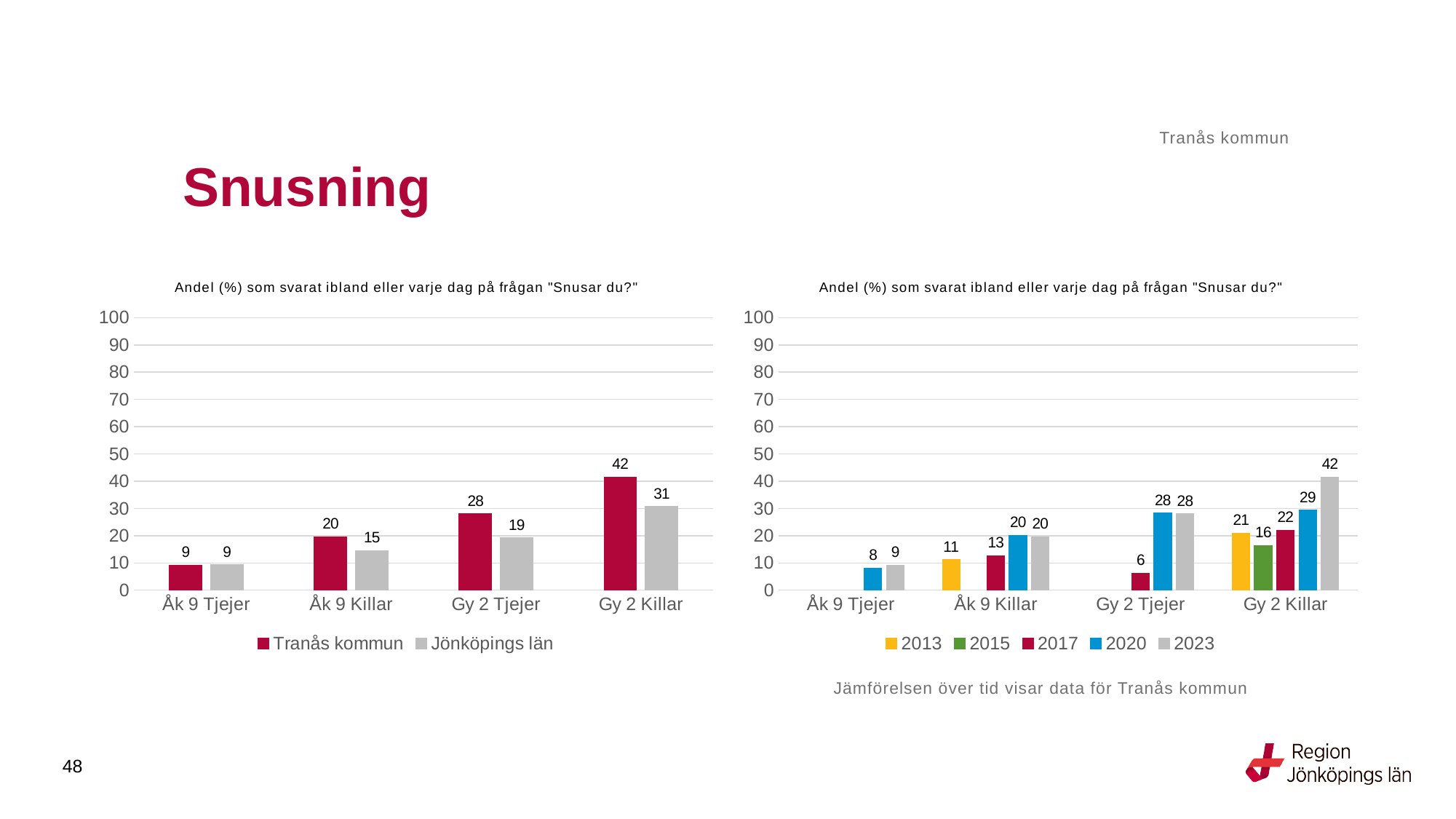
What kind of chart is the left chart? Bar chart In the left chart, which category has the highest value for Tranås kommun? Gy 2 Killar In the left chart, how many series does the legend list? 2 In the right chart, what is the value for 2017 for Gy 2 Tjejer? 6 In the left chart, what is the value for Jönköpings län for Åk 9 Killar? 15 How many categories are shown on the x axis of the right chart? 4 In the right chart, which is larger for Gy 2 Killar: the value for 2015 or the value for 2020? 2020 In the left chart, what is the difference between Tranås kommun and Jönköpings län for Gy 2 Tjejer? 9 In the right chart, what is the difference between the 2013 and 2023 values for Gy 2 Killar? 21 In the left chart, what is the value for Tranås kommun for Gy 2 Killar? 42 In the right chart, what is the value for 2023 for Gy 2 Killar? 42 In the right chart, how many series does the legend list? 5